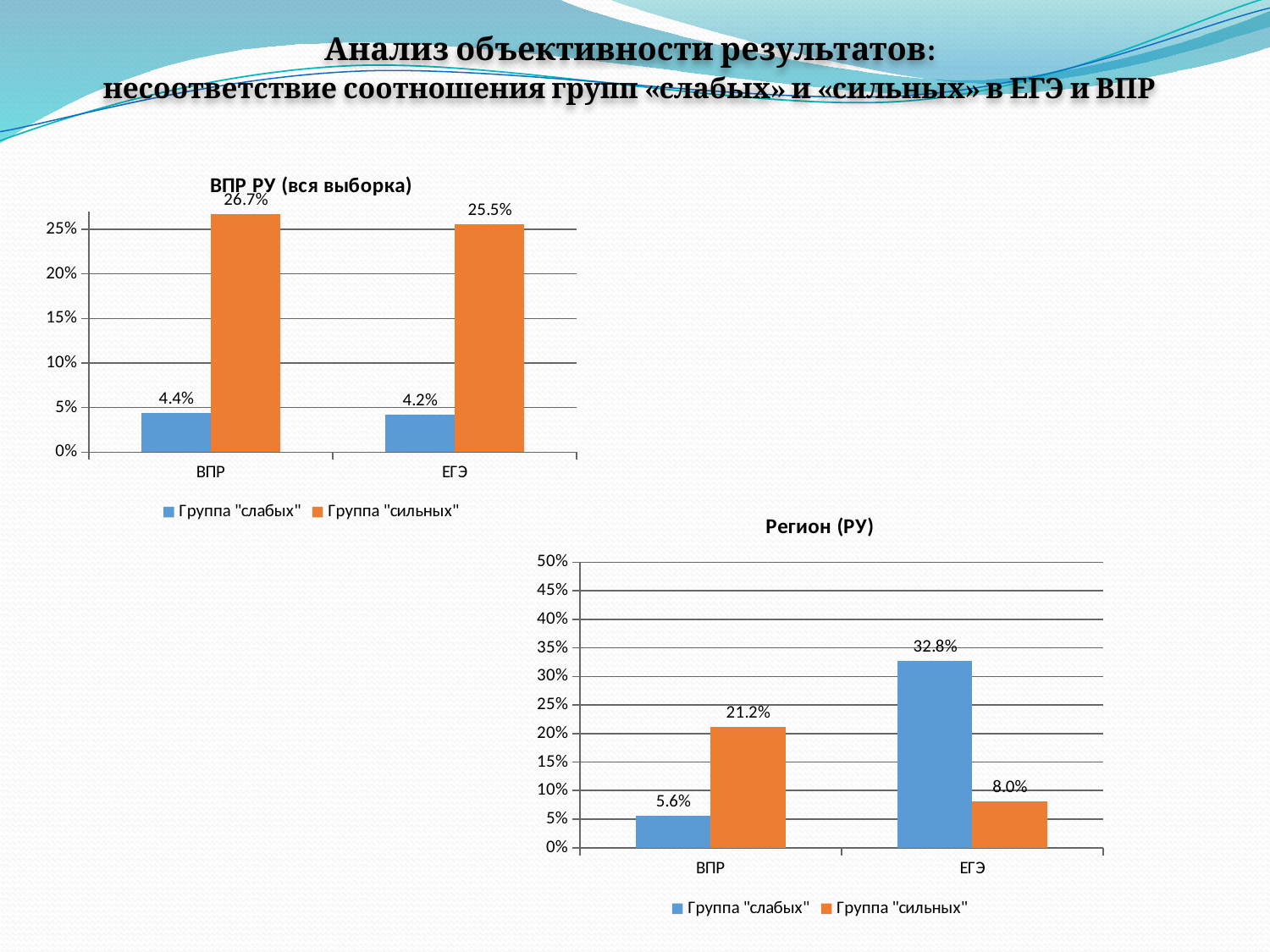
In the chart titled "Регион (РУ)", what is the value for Группа "сильных" at ВПР? 21.2% In the chart titled "ВПР РУ (вся выборка)", what is the value for Группа "слабых" at ЕГЭ? 4.2% How many series does the legend of the chart titled "Регион (РУ)" list? 2 In the chart titled "ВПР РУ (вся выборка)", what is the difference between Группа "сильных" at ВПР and at ЕГЭ? 1.2% In the chart titled "Регион (РУ)", what is the value for Группа "слабых" at ЕГЭ? 32.8% In the chart titled "ВПР РУ (вся выборка)", which bar has the lowest value? Группа "слабых" at ЕГЭ In the chart titled "Регион (РУ)", which is larger at ВПР: Группа "слабых" or Группа "сильных"? Группа "сильных" What kind of chart is the chart titled "ВПР РУ (вся выборка)"? Bar chart In the chart titled "Регион (РУ)", which bar has the highest value? Группа "слабых" at ЕГЭ In the chart titled "ВПР РУ (вся выборка)", what is the value for Группа "сильных" at ВПР? 26.7% In the chart titled "Регион (РУ)", what is the difference between Группа "слабых" and Группа "сильных" at ЕГЭ? 24.8% In the chart titled "Регион (РУ)", what colour represents Группа "сильных"? Orange